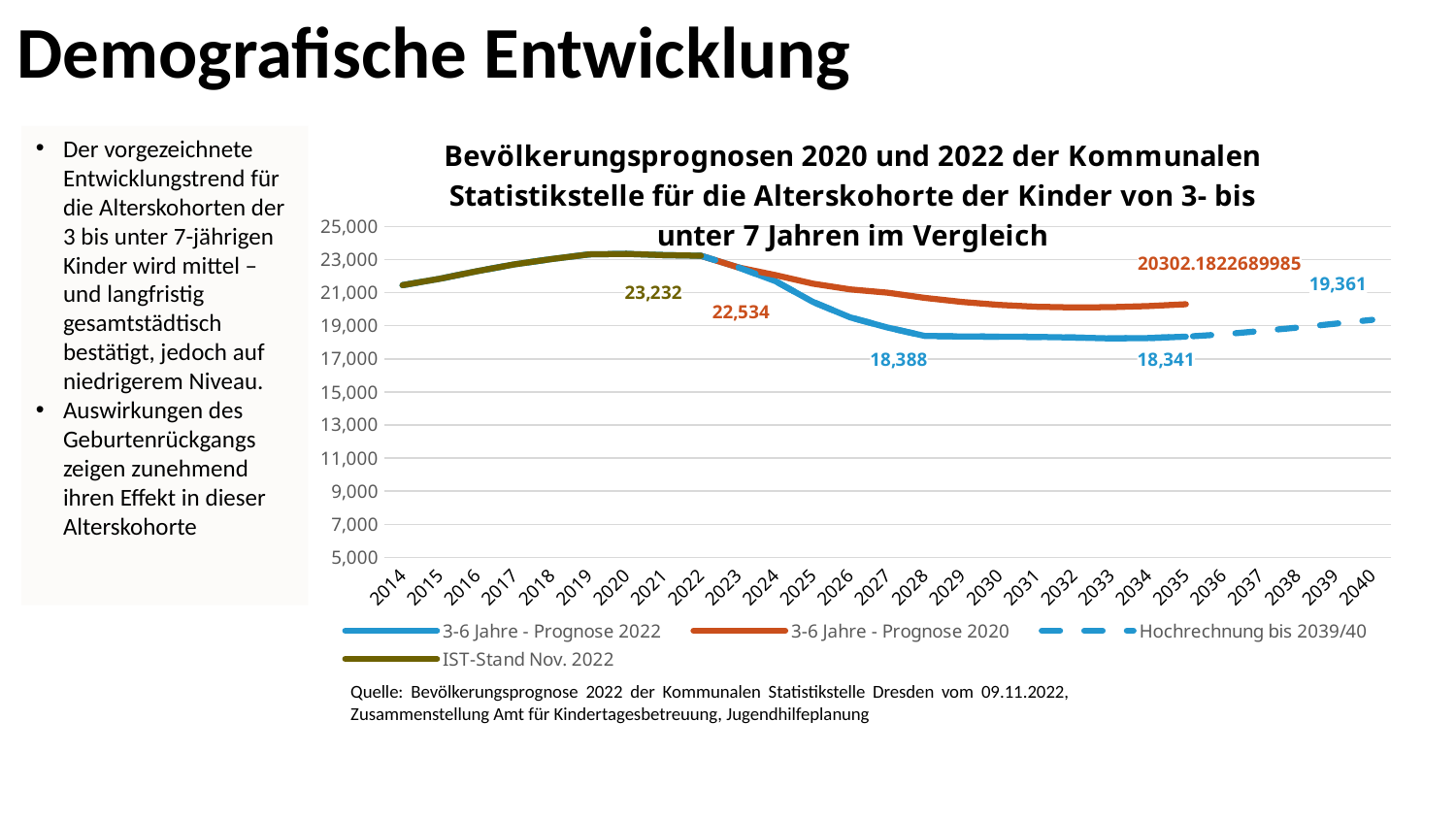
How many series does the chart legend list? 4 What is the difference between the two labelled values on the '3-6 Jahre - Prognose 2022' line, 18,388 and 18,341? 47 What value is labelled on the 'IST-Stand Nov. 2022' line? 23,232 In 2035, which line is higher: '3-6 Jahre - Prognose 2020' or '3-6 Jahre - Prognose 2022'? 3-6 Jahre - Prognose 2020 Is the value of the 'IST-Stand Nov. 2022' line in 2014 greater or less than 23,000? less What is the first labelled value on the '3-6 Jahre - Prognose 2020' line? 22,534 Which series in the legend is drawn with a dashed line? Hochrechnung bis 2039/40 What value is labelled at the end of the 'Hochrechnung bis 2039/40' line in 2040? 19,361 What value is labelled at the end of the '3-6 Jahre - Prognose 2020' line in 2035? 20302.1822689985 Is the value of the '3-6 Jahre - Prognose 2022' line in 2030 greater or less than 19,000? less Does the '3-6 Jahre - Prognose 2022' line rise or fall between 2022 and 2028? fall What type of chart is shown on the slide? line chart